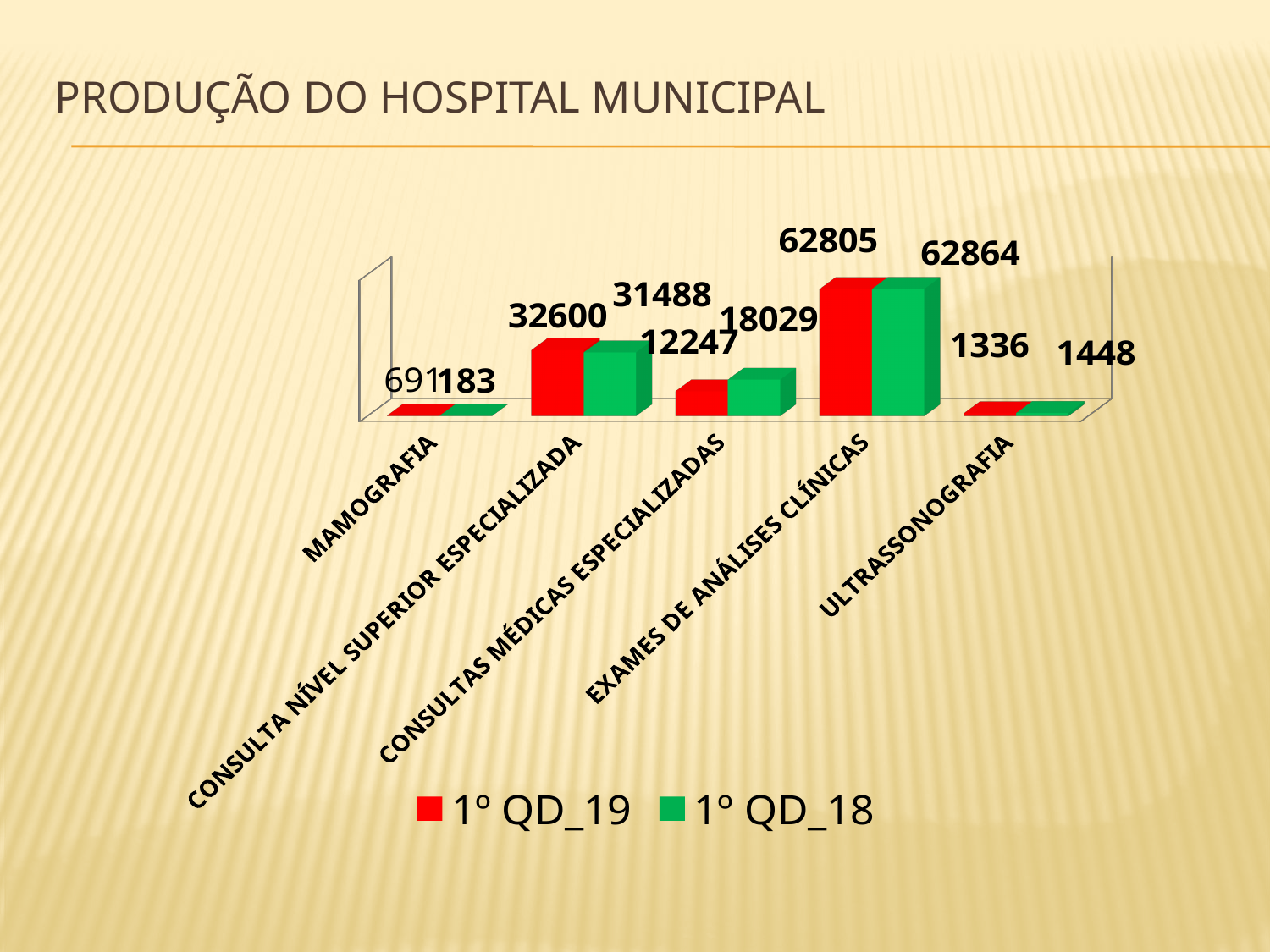
For CONSULTA NÍVEL SUPERIOR ESPECIALIZADA, which series has the larger value, 1º QD_19 or 1º QD_18? 1º QD_19 What is the value for CONSULTA NÍVEL SUPERIOR ESPECIALIZADA in the 1º QD_19 series? 32600 Which category has the highest value in the 1º QD_18 series? EXAMES DE ANÁLISES CLÍNICAS What kind of chart is shown on the slide? Bar chart How many categories are shown on the x axis of the chart? 5 What is the value for CONSULTA NÍVEL SUPERIOR ESPECIALIZADA in the 1º QD_18 series? 31488 What is the value for EXAMES DE ANÁLISES CLÍNICAS in the 1º QD_19 series? 62805 How many series does the legend list? 2 What is the value for CONSULTAS MÉDICAS ESPECIALIZADAS in the 1º QD_19 series? 12247 What is the difference between the 1º QD_18 and 1º QD_19 values for CONSULTAS MÉDICAS ESPECIALIZADAS? 5782 What is the value for CONSULTAS MÉDICAS ESPECIALIZADAS in the 1º QD_18 series? 18029 What is the value for ULTRASSONOGRAFIA in the 1º QD_18 series? 1448